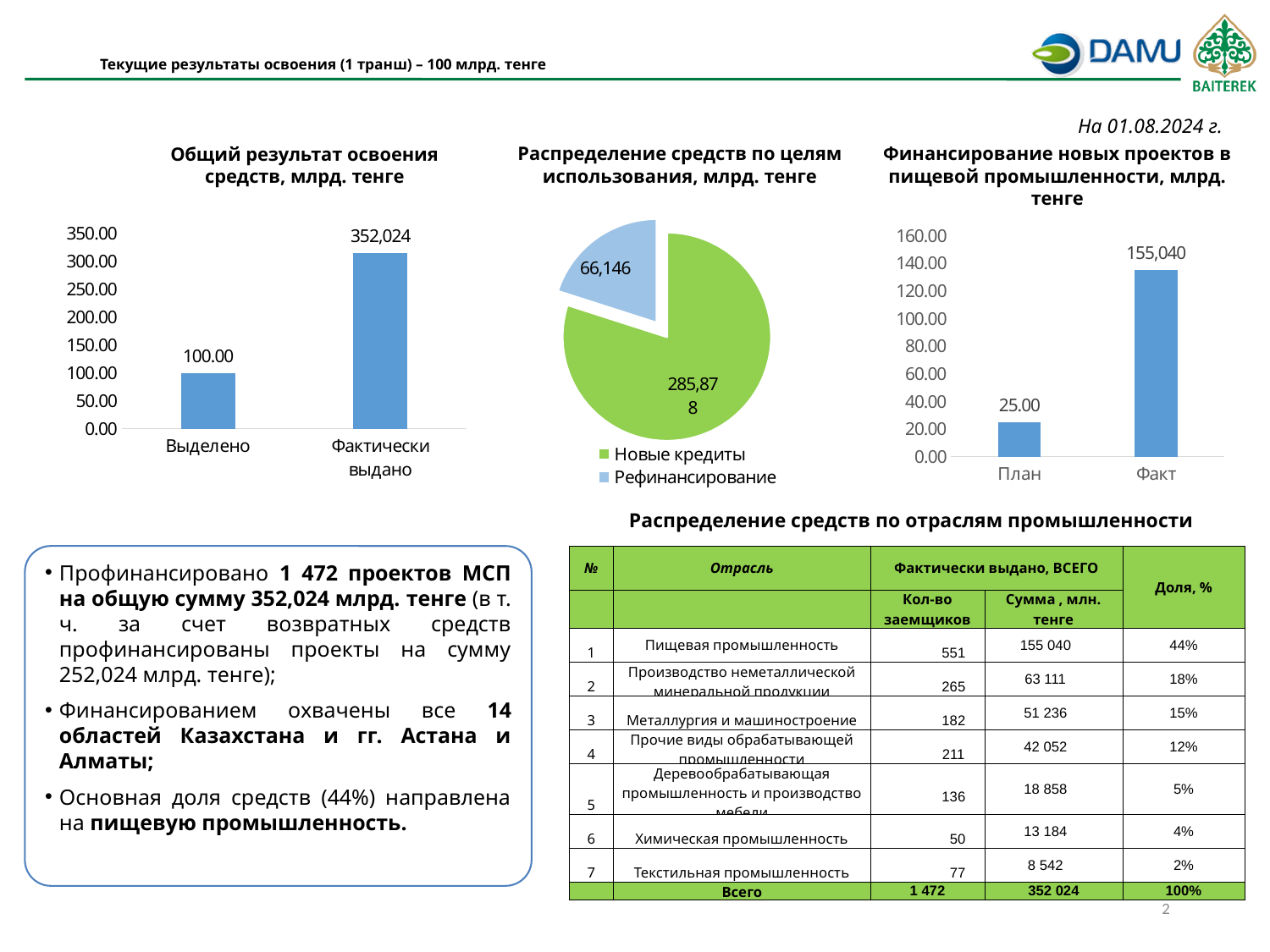
In the chart 'Общий результат освоения средств, млрд. тенге', what is the difference between 'Фактически выдано' and 'Выделено'? 252,024 In the pie chart 'Распределение средств по целям использования, млрд. тенге', what is the value for 'Рефинансирование'? 66,146 In the chart 'Финансирование новых проектов в пищевой промышленности, млрд. тенге', what is the value for 'План'? 25.00 In the pie chart 'Распределение средств по целям использования, млрд. тенге', what is the value for 'Новые кредиты'? 285,878 In the chart 'Финансирование новых проектов в пищевой промышленности, млрд. тенге', what is the value for 'Факт'? 155,040 How many categories are shown on the x axis of the chart 'Финансирование новых проектов в пищевой промышленности, млрд. тенге'? 2 In the chart 'Общий результат освоения средств, млрд. тенге', what is the value for 'Выделено'? 100.00 What kind of chart is 'Общий результат освоения средств, млрд. тенге'? Bar chart In the chart 'Финансирование новых проектов в пищевой промышленности, млрд. тенге', which category is the lowest? План In the pie chart 'Распределение средств по целям использования, млрд. тенге', which slice is larger, 'Новые кредиты' or 'Рефинансирование'? Новые кредиты How many entries does the legend of the pie chart 'Распределение средств по целям использования, млрд. тенге' list? 2 In the chart 'Общий результат освоения средств, млрд. тенге', what is the value for 'Фактически выдано'? 352,024